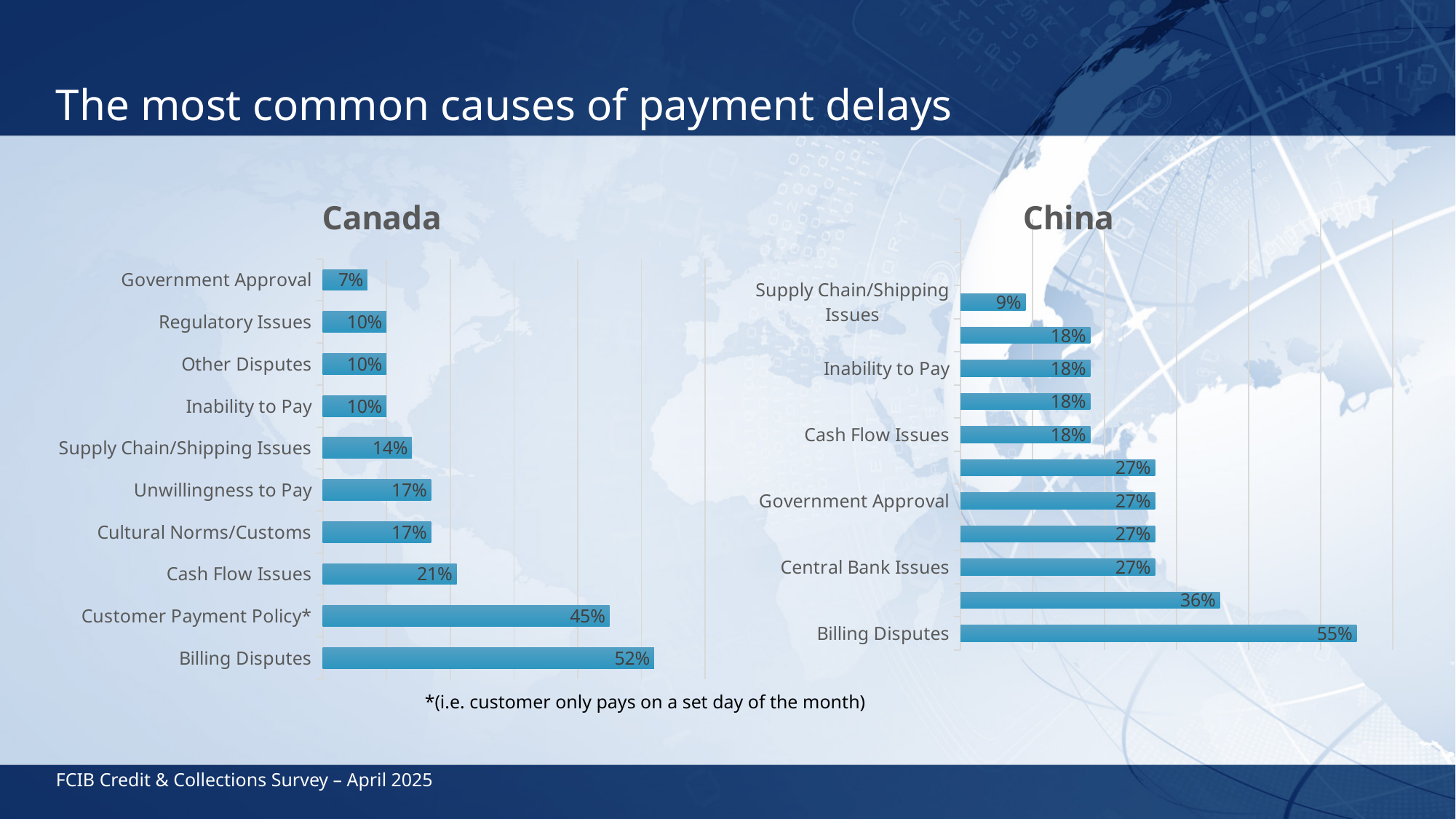
In the Canada chart, what is the difference between Billing Disputes and Customer Payment Policy*? 7% In the China chart, what is the value for Central Bank Issues? 27% In the China chart, which is larger, Government Approval or Cash Flow Issues? Government Approval In the Canada chart, what is the value for Supply Chain/Shipping Issues? 14% In the Canada chart, how many categories are shown? 10 In the China chart, what is the value for Supply Chain/Shipping Issues? 9% In the China chart, what is the value for Billing Disputes? 55% In the Canada chart, what is the value for Customer Payment Policy*? 45% In the China chart, what is the difference between Billing Disputes and Inability to Pay? 37% What kind of chart is the Canada chart? Bar chart In the Canada chart, what is the value for Billing Disputes? 52% In the Canada chart, which category has the lowest value? Government Approval